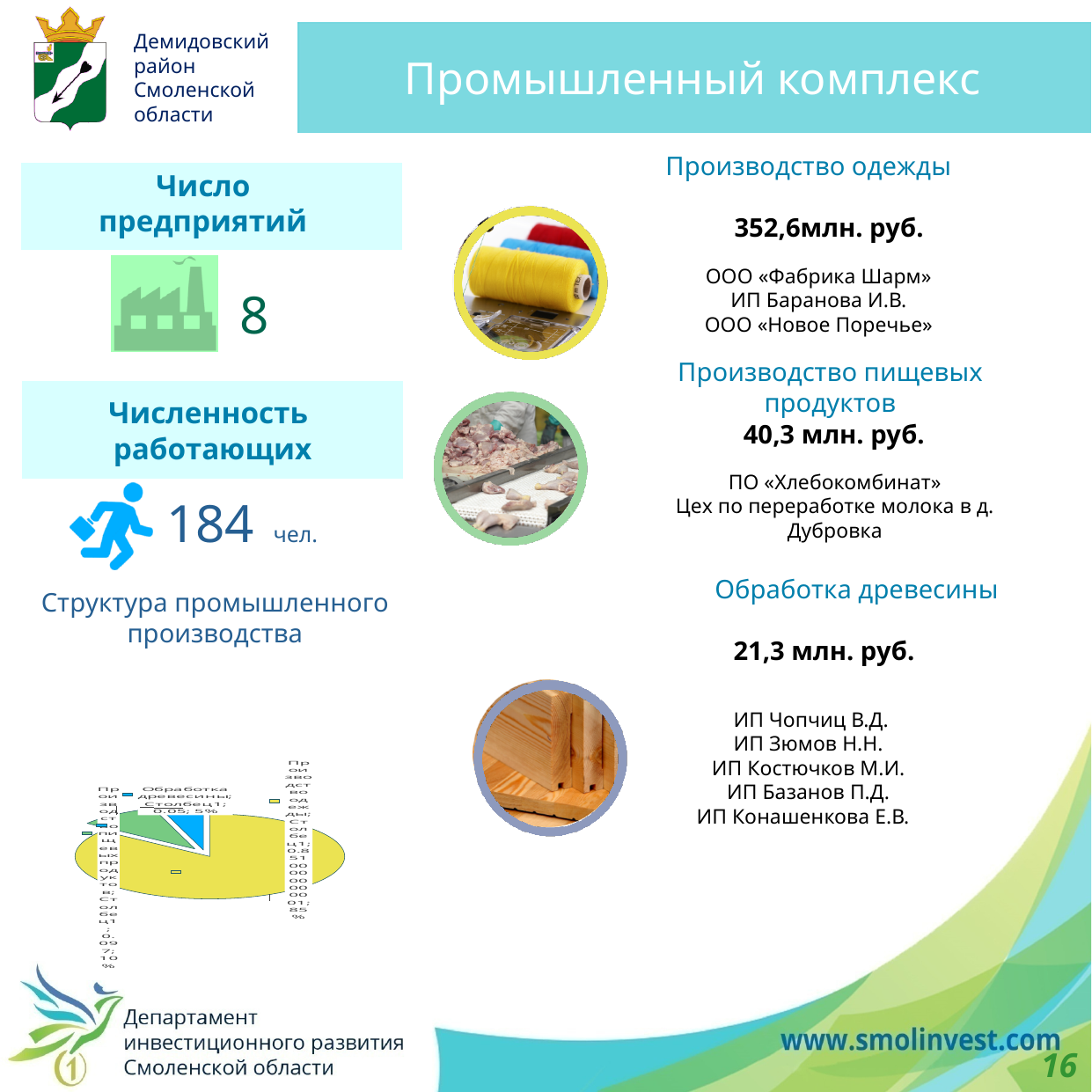
How many slices does the pie chart «Структура промышленного производства» have? 3 What kind of chart is shown under the heading «Структура промышленного производства»? pie chart In the pie chart «Структура промышленного производства», which is larger: the slice for «Производство пищевых продуктов» or the slice for «Обработка древесины»? Производство пищевых продуктов What share of the pie chart «Структура промышленного производства» does «Производство одежды» take? 85% What colour is the largest slice in the pie chart «Структура промышленного производства»? yellow What share of the pie chart «Структура промышленного производства» does «Обработка древесины» take? 5% What is the title of the pie chart on the slide? Структура промышленного производства In the pie chart «Структура промышленного производства», by how many percentage points does the «Производство одежды» slice exceed the «Обработка древесины» slice? 80 percentage points Which category has the smallest slice in the pie chart «Структура промышленного производства»? Обработка древесины What share of the pie chart «Структура промышленного производства» does «Производство пищевых продуктов» take? 10% Which category has the largest slice in the pie chart «Структура промышленного производства»? Производство одежды